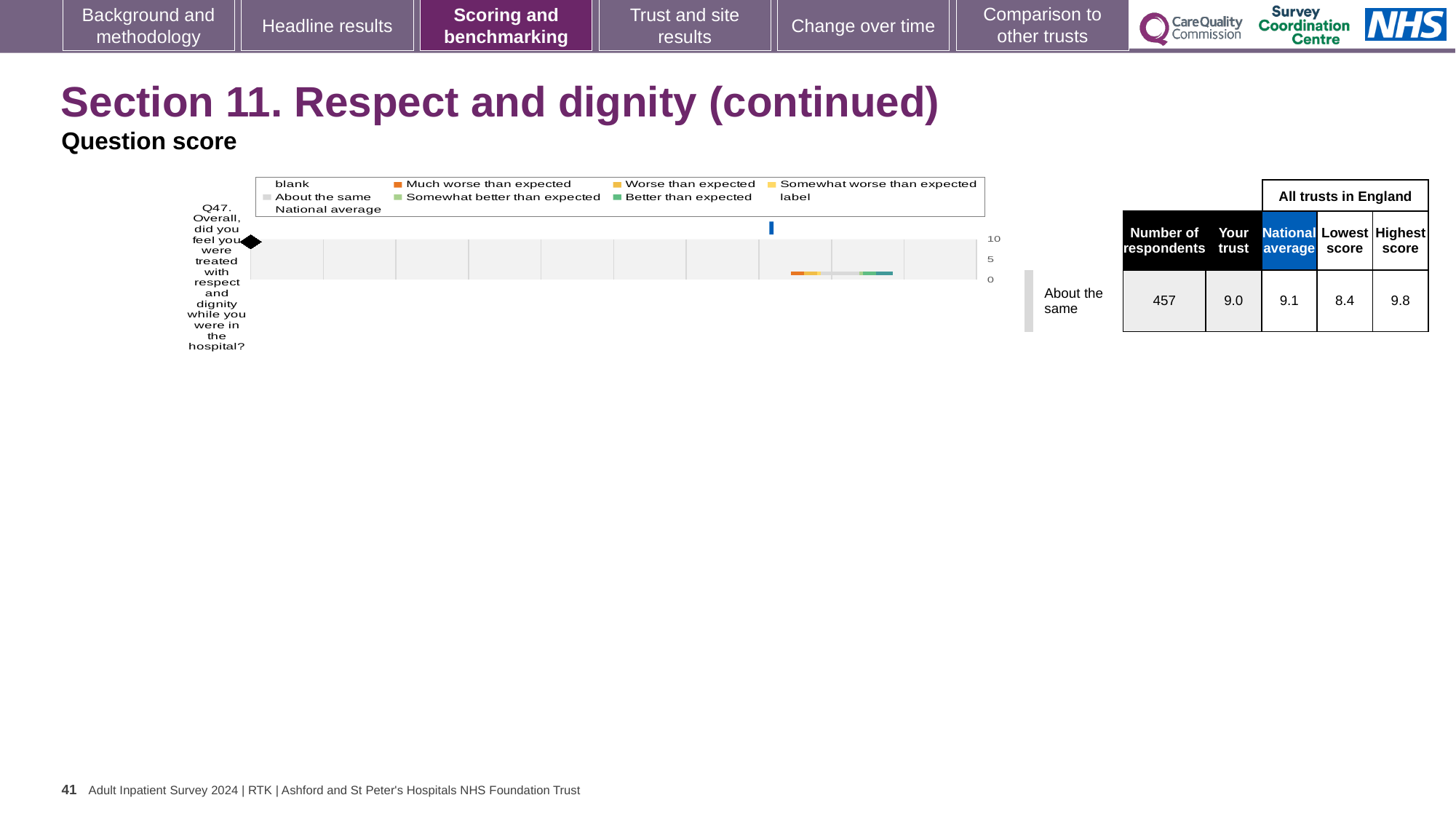
In the table beside the chart, what is the lowest score among all trusts in England for Q47? 8.4 How many entries does the chart's legend list? 9 In the table beside the chart, what is the highest score among all trusts in England for Q47? 9.8 Which benchmark category is the trust's result for Q47 placed in, as labelled beside the chart? About the same What is the difference between the highest score and the lowest score for Q47 in the table beside the chart? 1.4 In the table beside the chart, what is the national average score for Q47? 9.1 What is the highest tick value shown on the chart's axis? 10 Is the 'Your trust' score for Q47 larger or smaller than the national average? smaller In the table beside the chart, what is the 'Your trust' score for Q47? 9.0 What kind of chart is shown on the slide? bar chart In the table beside the chart, what is the number of respondents for Q47? 457 How many questions (categories) are plotted on the chart? 1